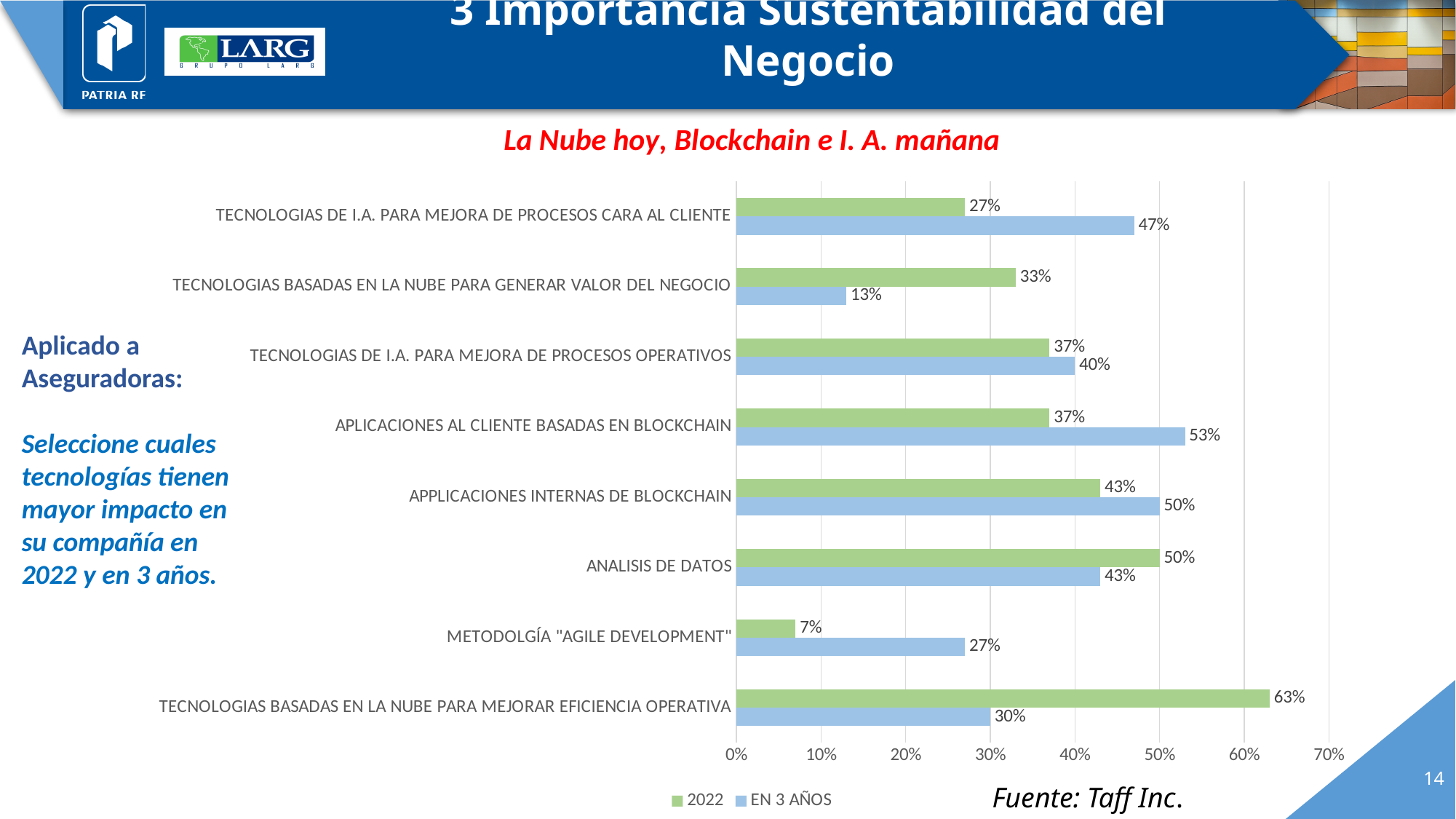
Which category has the lowest 2022 value? METODOLGÍA "AGILE DEVELOPMENT" What is the 2022 value for TECNOLOGIAS BASADAS EN LA NUBE PARA MEJORAR EFICIENCIA OPERATIVA? 63% Which category has the lowest EN 3 AÑOS value? TECNOLOGIAS BASADAS EN LA NUBE PARA GENERAR VALOR DEL NEGOCIO What kind of chart is shown on the slide? Bar chart Which category has the highest 2022 value? TECNOLOGIAS BASADAS EN LA NUBE PARA MEJORAR EFICIENCIA OPERATIVA Is the EN 3 AÑOS value for APPLICACIONES INTERNAS DE BLOCKCHAIN greater or less than 40%? greater For ANALISIS DE DATOS, which is larger: the 2022 value or the EN 3 AÑOS value? 2022 What is the difference between the EN 3 AÑOS and 2022 values for TECNOLOGIAS DE I.A. PARA MEJORA DE PROCESOS CARA AL CLIENTE? 20% How many series does the legend list? 2 How many categories are shown in the chart? 8 What is the EN 3 AÑOS value for METODOLGÍA "AGILE DEVELOPMENT"? 27% What is the EN 3 AÑOS value for APLICACIONES AL CLIENTE BASADAS EN BLOCKCHAIN? 53%